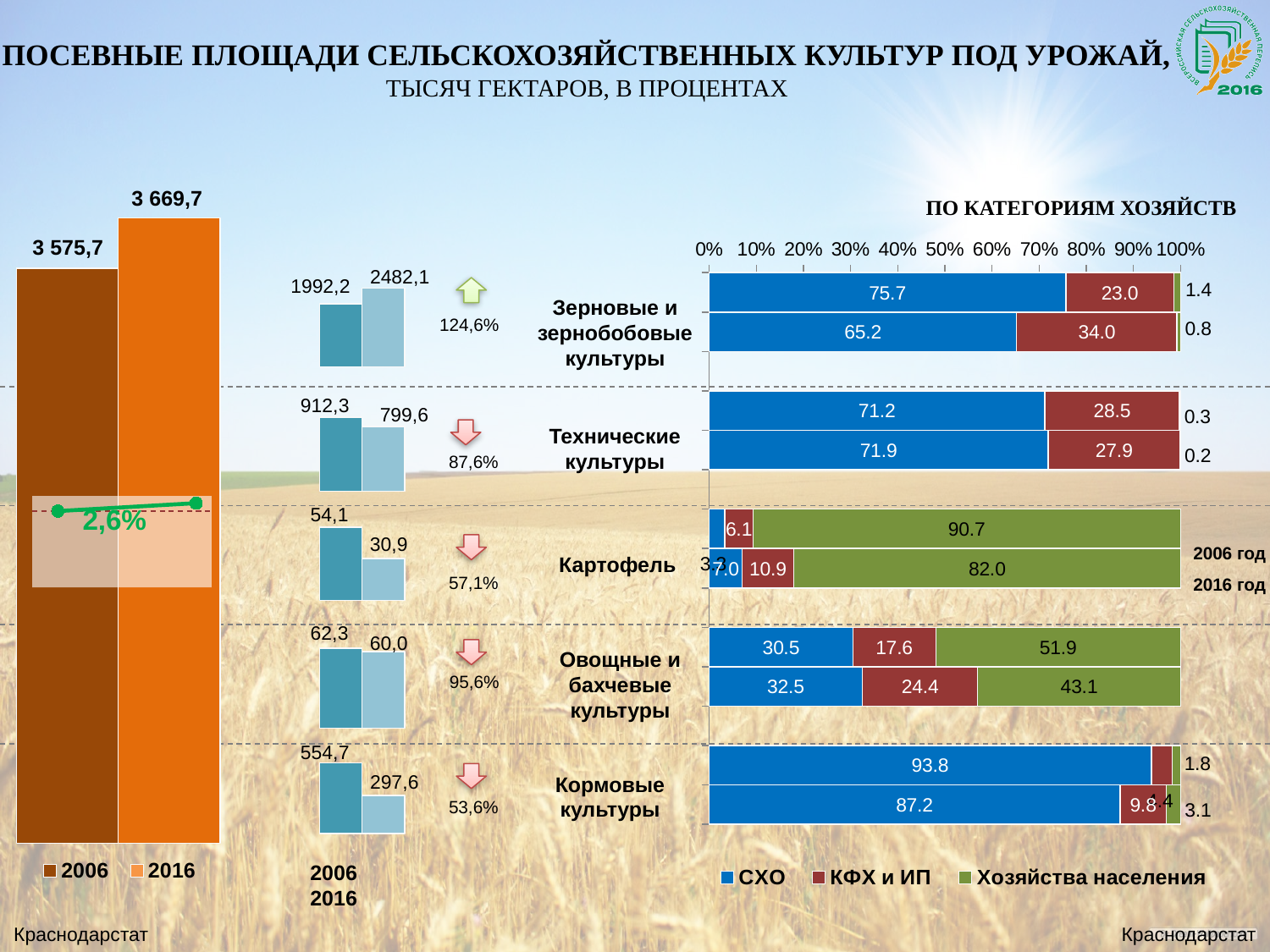
In the stacked bar chart 'ПО КАТЕГОРИЯМ ХОЗЯЙСТВ', what is the СХО share for Зерновые и зернобобовые культуры in 2016? 65.2 In the small bar chart for Технические культуры, which year has the larger value, 2006 or 2016? 2006 In the large bar chart on the left of the slide, what is the value for 2006? 3 575,7 In the small bar chart for Картофель, what is the difference between the 2006 and 2016 values? 23,2 In the large bar chart on the left of the slide, which year has the larger value, 2006 or 2016? 2016 In the small bar chart for Зерновые и зернобобовые культуры, what is the value for 2016? 2482,1 In the stacked bar chart 'ПО КАТЕГОРИЯМ ХОЗЯЙСТВ', how many series does the legend list? 3 What kind of chart is the chart titled 'ПО КАТЕГОРИЯМ ХОЗЯЙСТВ'? Stacked bar chart In the large bar chart on the left of the slide, how many series does the legend list? 2 In the small bar chart for Кормовые культуры, what is the value for 2006? 554,7 In the large bar chart on the left of the slide, what is the value for 2016? 3 669,7 In the stacked bar chart 'ПО КАТЕГОРИЯМ ХОЗЯЙСТВ', what is the Хозяйства населения share for Картофель in 2006? 90.7